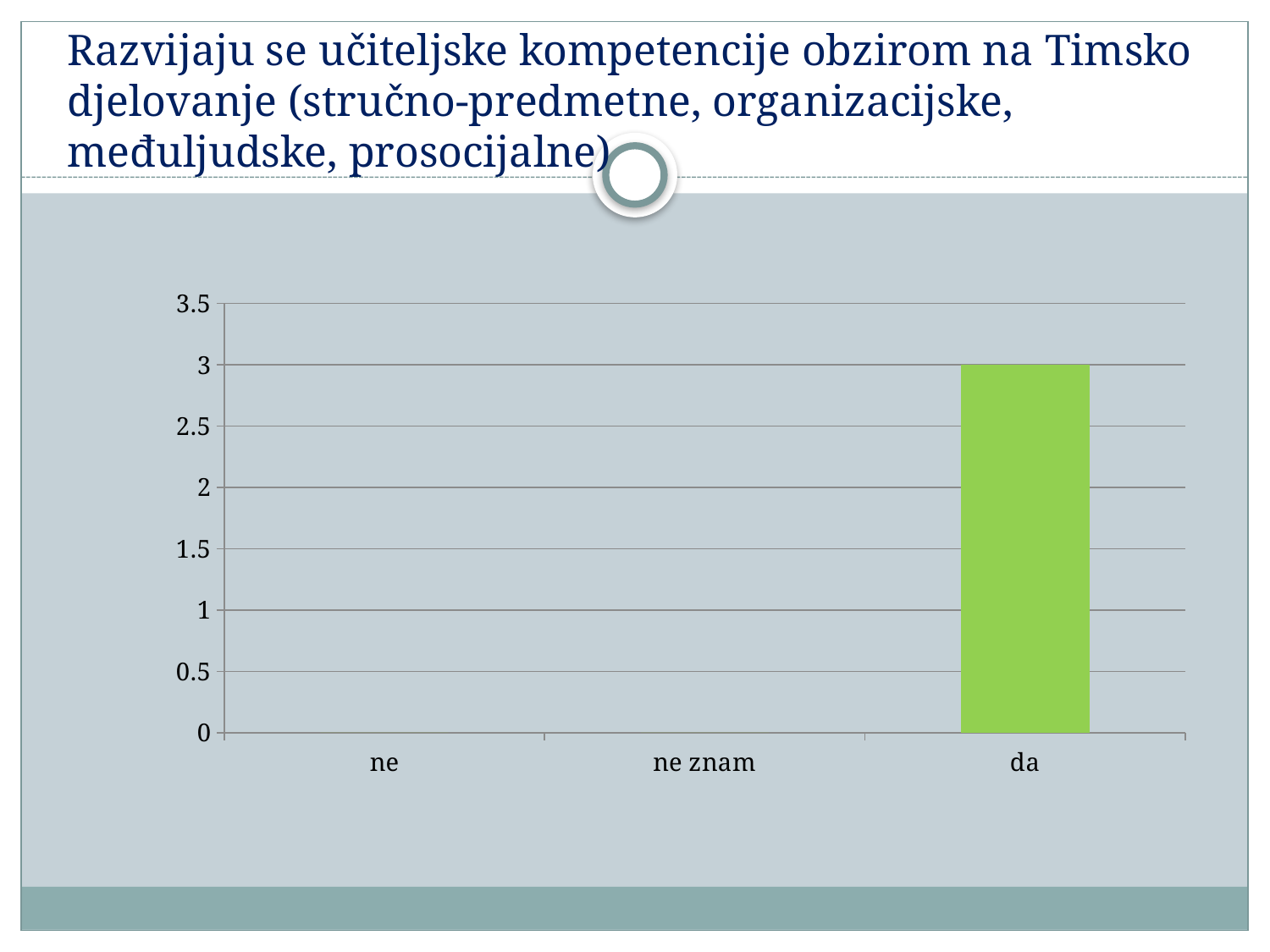
Which has the larger value, "ne znam" or "da"? da How many categories are shown on the x axis of the chart? 3 What kind of chart is shown on the slide? bar chart What is the value for "da" in the chart? 3 What colour is the bar for "da"? green Which has the larger value, "ne" or "da"? da What is the value for "ne" in the chart? 0 Is the value for "da" greater or less than 3.5? less Which category has the highest value in the chart? da What is the highest value labelled on the y axis of the chart? 3.5 Is the value for "da" greater or less than 2.5? greater